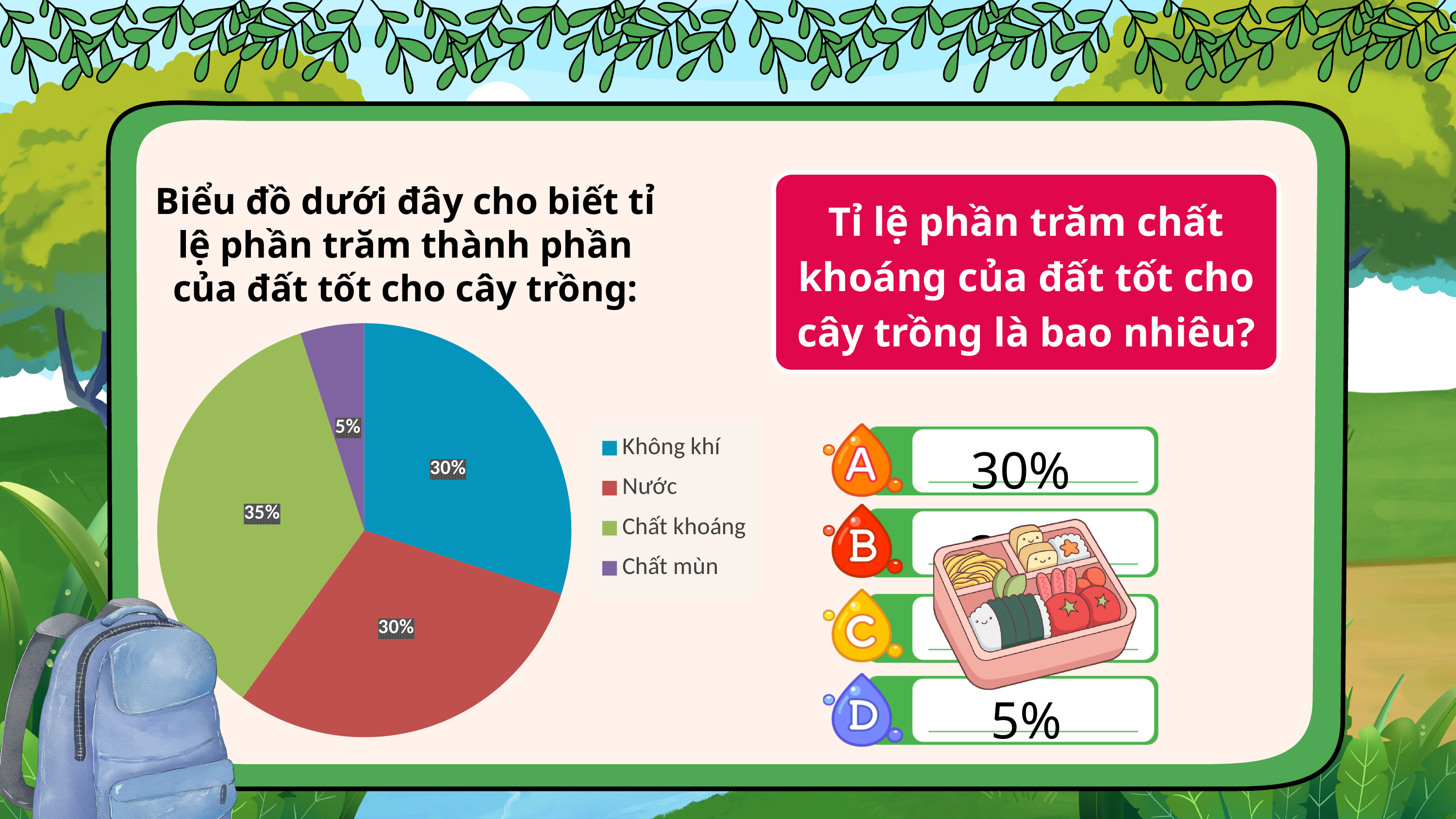
What is the difference between the percentages for Chất khoáng and Chất mùn? 30% What percentage does the pie chart show for Nước? 30% Which is larger in the pie chart, Chất khoáng or Không khí? Chất khoáng What percentage does the pie chart show for Chất mùn? 5% What colour is the Nước slice in the pie chart? red What kind of chart is shown on the slide? pie chart Which category has the smallest slice in the pie chart? Chất mùn What percentage does the pie chart show for Không khí? 30% How many entries does the legend of the pie chart list? 4 What percentage does the pie chart show for Chất khoáng? 35% Which category has the largest slice in the pie chart? Chất khoáng How many categories does the pie chart show? 4